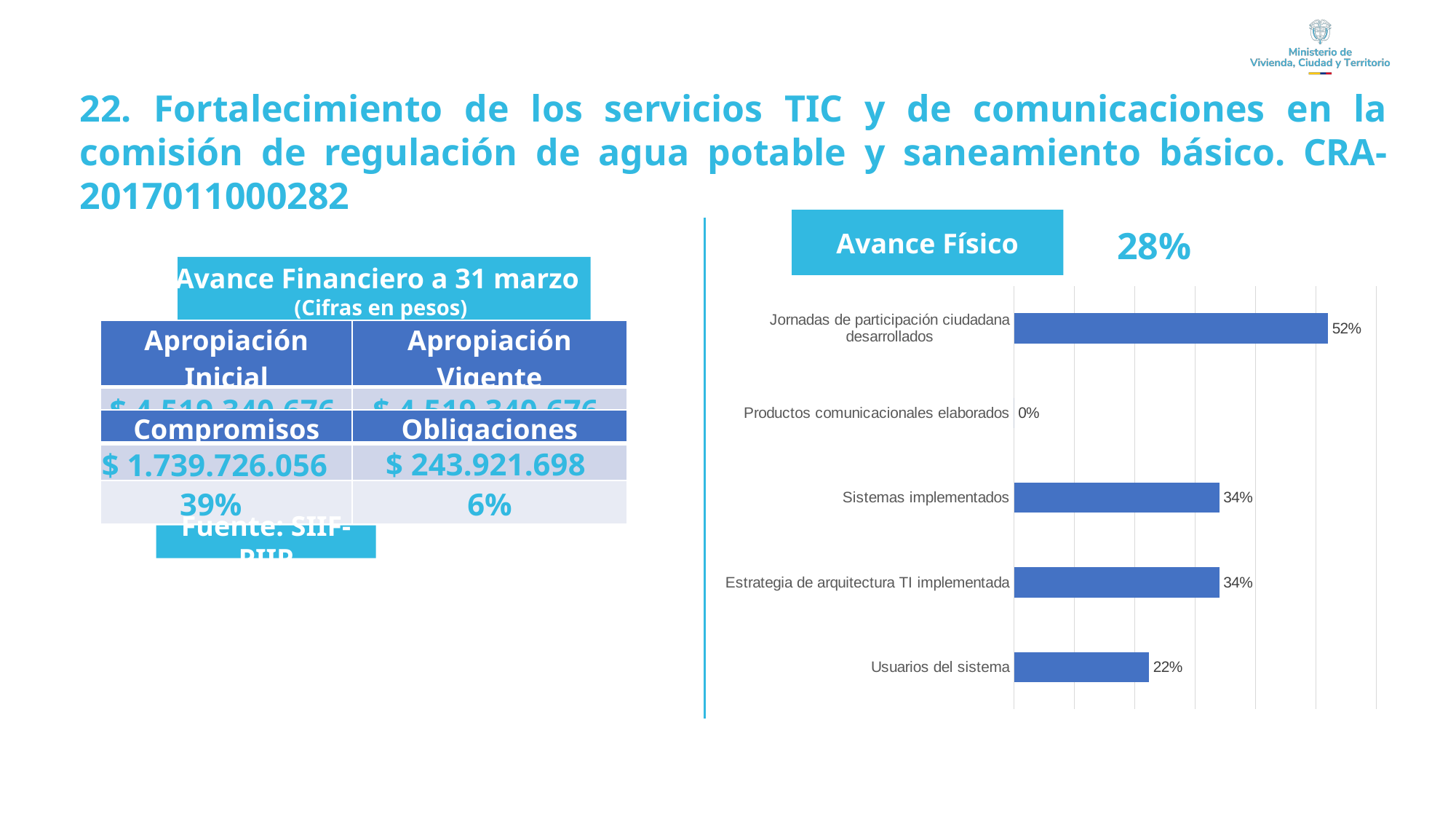
How many categories are shown in the bar chart? 5 What is the difference between the values for Estrategia de arquitectura TI implementada and Usuarios del sistema? 12% What is the value for Usuarios del sistema? 22% What is the value for Sistemas implementados? 34% What kind of chart is shown on the slide? Bar chart What is the difference between the values for Jornadas de participación ciudadana desarrollados and Usuarios del sistema? 30% What is the title shown above the bar chart? Avance Físico Which is larger, the value for Sistemas implementados or the value for Usuarios del sistema? Sistemas implementados Which category has the lowest value? Productos comunicacionales elaborados What is the value for Productos comunicacionales elaborados? 0% What is the value for Jornadas de participación ciudadana desarrollados? 52% Which category has the highest value? Jornadas de participación ciudadana desarrollados